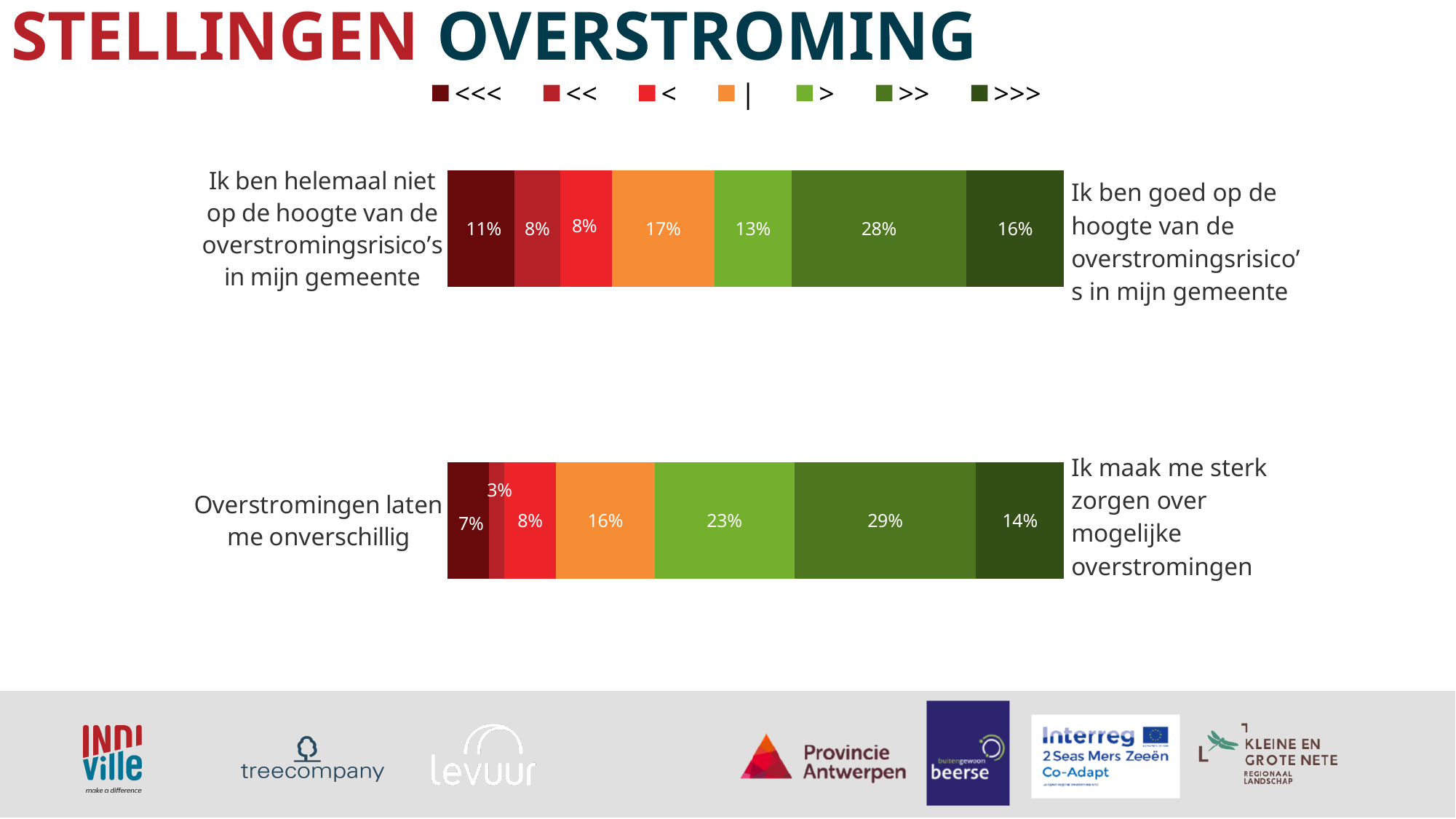
What is the total of all segments in the 'Overstromingen laten me onverschillig' bar? 100% How many bars are plotted on the slide? 2 What is the difference between the '>' segment in the 'Overstromingen laten me onverschillig' bar and the '>' segment in the 'Ik ben helemaal niet op de hoogte' bar? 10% Which is larger: the '<<<' segment in the 'Ik ben helemaal niet op de hoogte' bar or the '<<<' segment in the 'Overstromingen laten me onverschillig' bar? Ik ben helemaal niet op de hoogte In the bar for 'Ik ben helemaal niet op de hoogte van de overstromingsrisico's in mijn gemeente', what is the value of the '>>' segment? 28% How many series does the legend list? 7 In the bar for 'Overstromingen laten me onverschillig', what is the value of the '<<' segment? 3% What kind of chart is shown on the slide? Stacked bar chart In the bar for 'Overstromingen laten me onverschillig', what is the value of the '|' segment? 16% In the bar for 'Ik ben helemaal niet op de hoogte van de overstromingsrisico's in mijn gemeente', which segment has the highest value? >> In the bar for 'Overstromingen laten me onverschillig', which segment has the lowest value? << What is the title of the slide? STELLINGEN OVERSTROMING